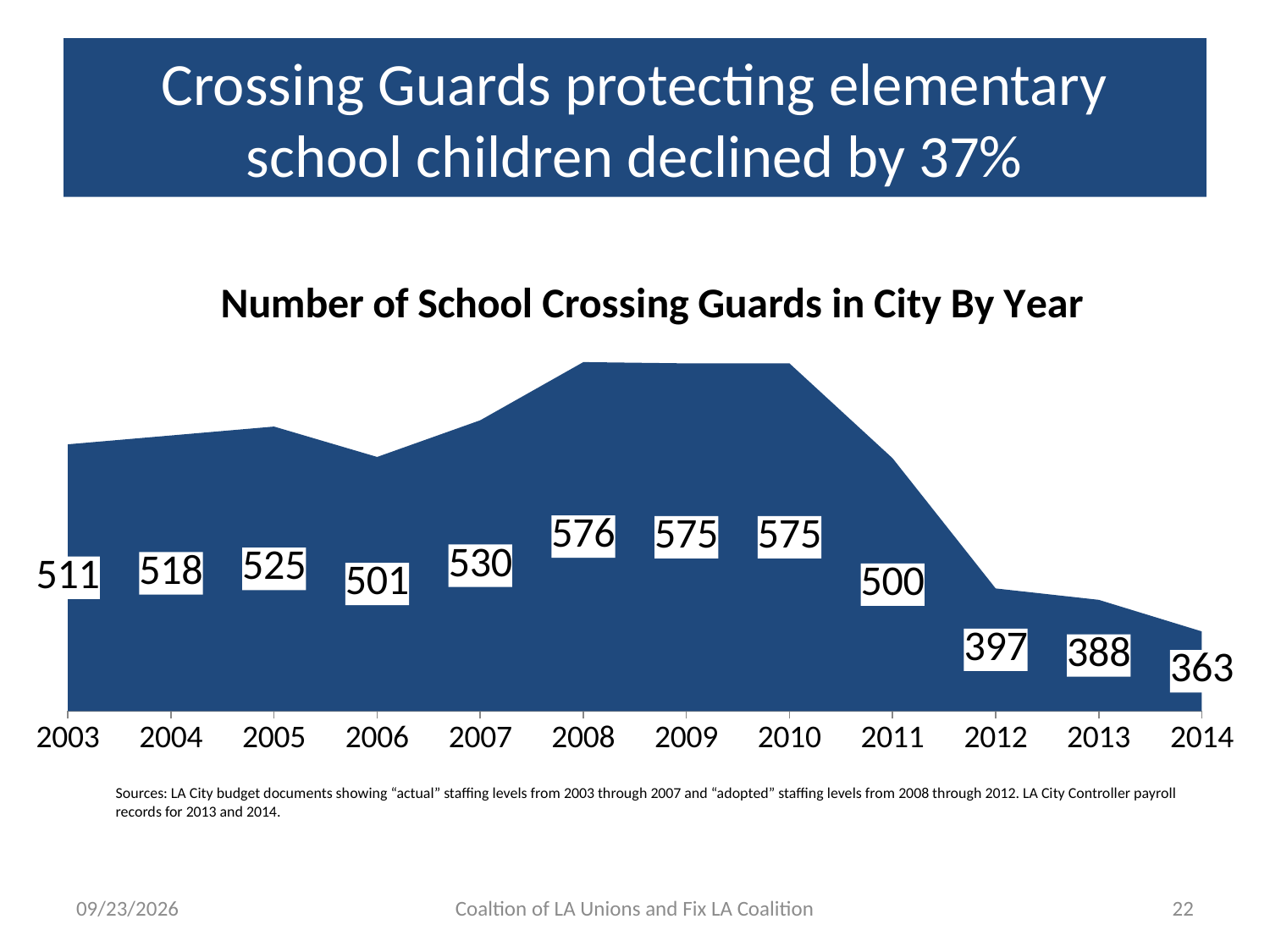
What is the number of school crossing guards in 2014? 363 What is the difference between the number of crossing guards in 2008 and in 2014? 213 How many years are shown on the x axis of the chart? 12 Which year has more crossing guards, 2006 or 2007? 2007 Which year has the lowest number of school crossing guards? 2014 What is the title of the chart? Number of School Crossing Guards in City By Year Do the values rise or fall from 2010 to 2014? Fall What is the difference between the number of crossing guards in 2011 and in 2012? 103 What is the number of school crossing guards in 2011? 500 What is the number of school crossing guards in 2003? 511 What kind of chart is shown on the slide? Area chart Which year has the highest number of school crossing guards? 2008